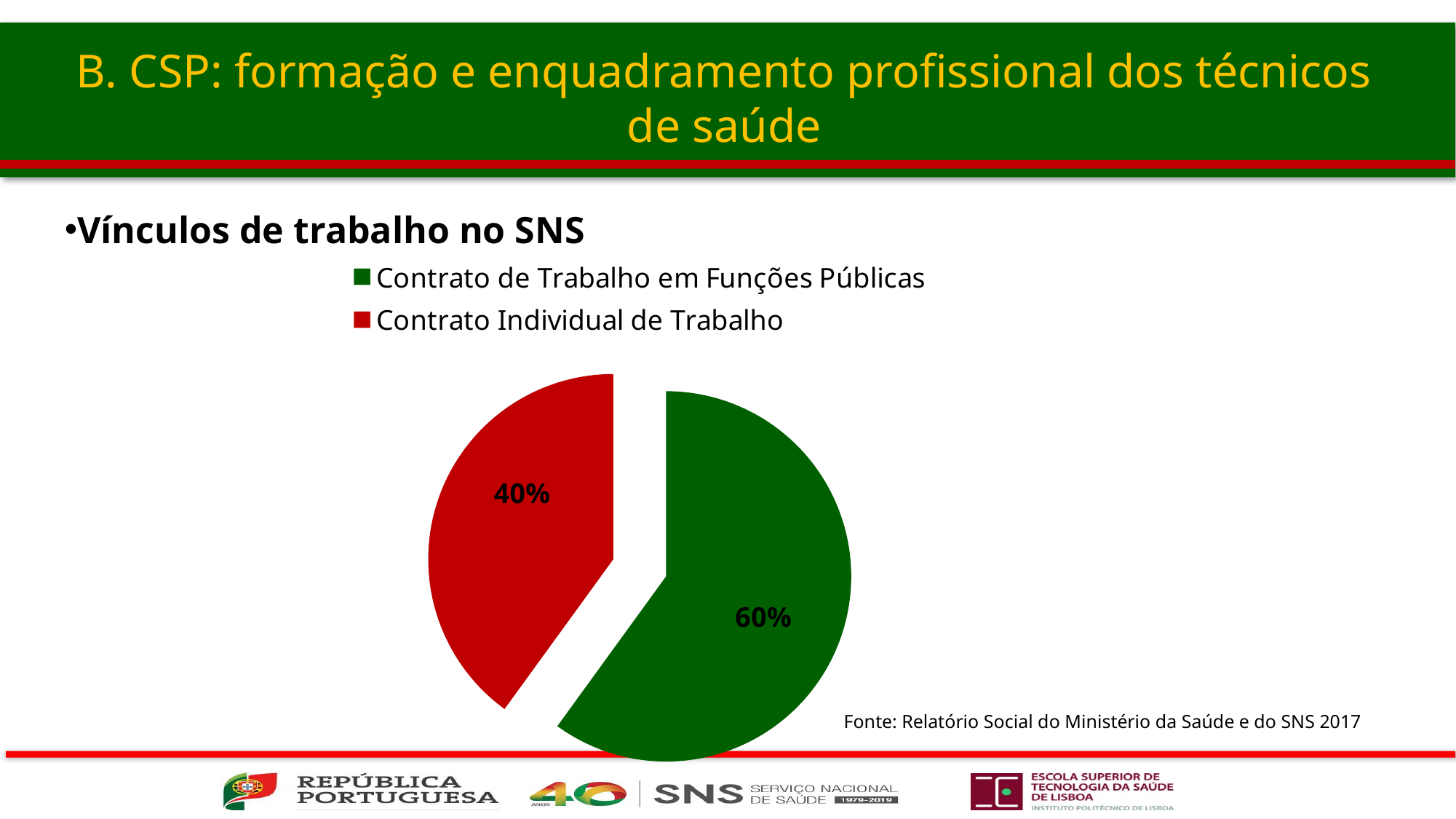
Which category has the smallest slice of the pie? Contrato Individual de Trabalho What colour is the slice for Contrato de Trabalho em Funções Públicas? green How many entries does the legend list? 2 What share of the pie is Contrato de Trabalho em Funções Públicas? 60% Which is larger: Contrato Individual de Trabalho or Contrato de Trabalho em Funções Públicas? Contrato de Trabalho em Funções Públicas What kind of chart is shown on the slide? pie chart What colour is the slice for Contrato Individual de Trabalho? red What is the difference in percentage points between Contrato de Trabalho em Funções Públicas and Contrato Individual de Trabalho? 20% How many slices does the pie chart have? 2 What share of the pie is Contrato Individual de Trabalho? 40% Which category has the largest slice of the pie? Contrato de Trabalho em Funções Públicas